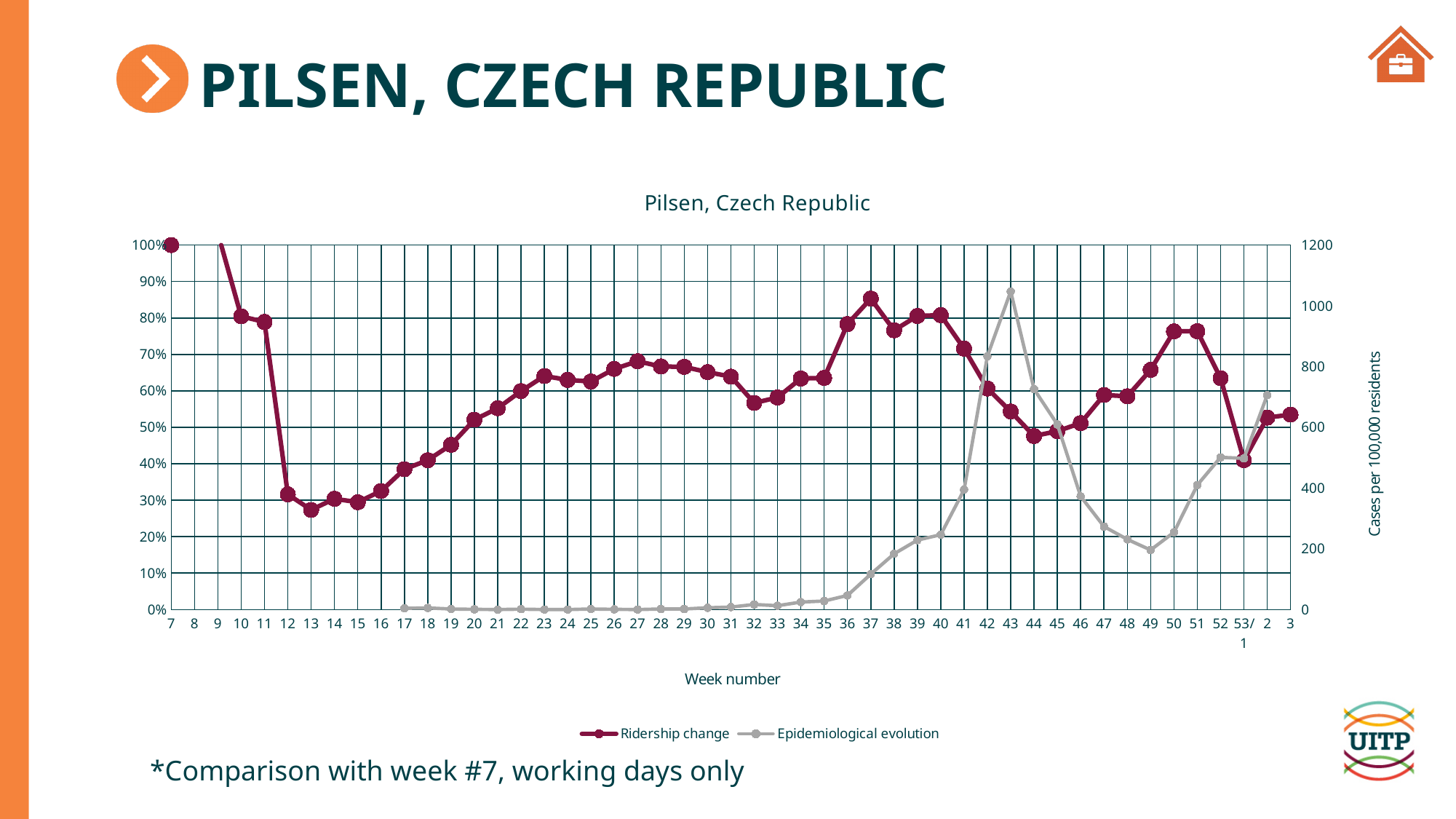
Is the Ridership change value for week 37 greater or less than 80%? greater What is the label of the right-hand vertical axis? Cases per 100,000 residents Which week has the highest Epidemiological evolution value? Week 43 What kind of chart is shown on the slide? Line chart Is the Epidemiological evolution value for week 49 greater or less than 400? less Which is larger, the Ridership change for week 37 or for week 44? Week 37 Is the Ridership change value for week 12 greater or less than 40%? less Does the Ridership change rise or fall from week 9 to week 13? Fall How many series does the legend list? 2 What is the Ridership change value for week 7? 100%